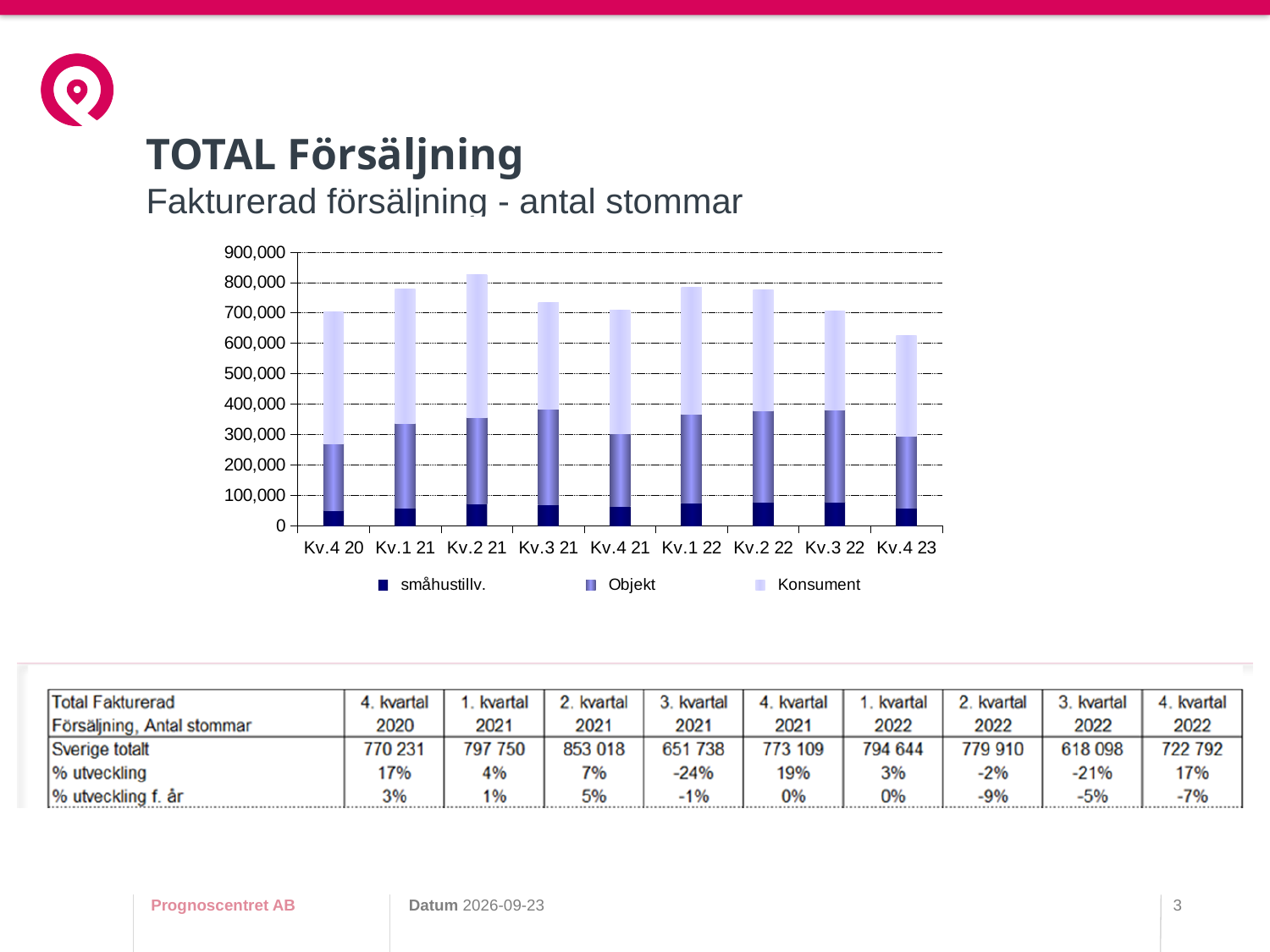
Is the total bar height for Kv.1 22 greater or less than 700,000? greater Is the total bar height for Kv.4 23 greater or less than 600,000? greater What kind of chart is shown on the slide? Stacked bar chart What is the subtitle of the chart on the slide? Fakturerad försäljning - antal stommar How many series does the chart's legend list? 3 Which quarter has the shortest stacked bar in the chart? Kv.4 23 Which has the taller stacked bar, Kv.1 21 or Kv.4 23? Kv.1 21 Which quarter has the tallest stacked bar in the chart? Kv.2 21 Which series is shown in the lightest colour at the top of each stacked bar? Konsument Is the total bar height for Kv.2 21 greater or less than 800,000? greater How many quarters (categories) are plotted along the x axis of the chart? 9